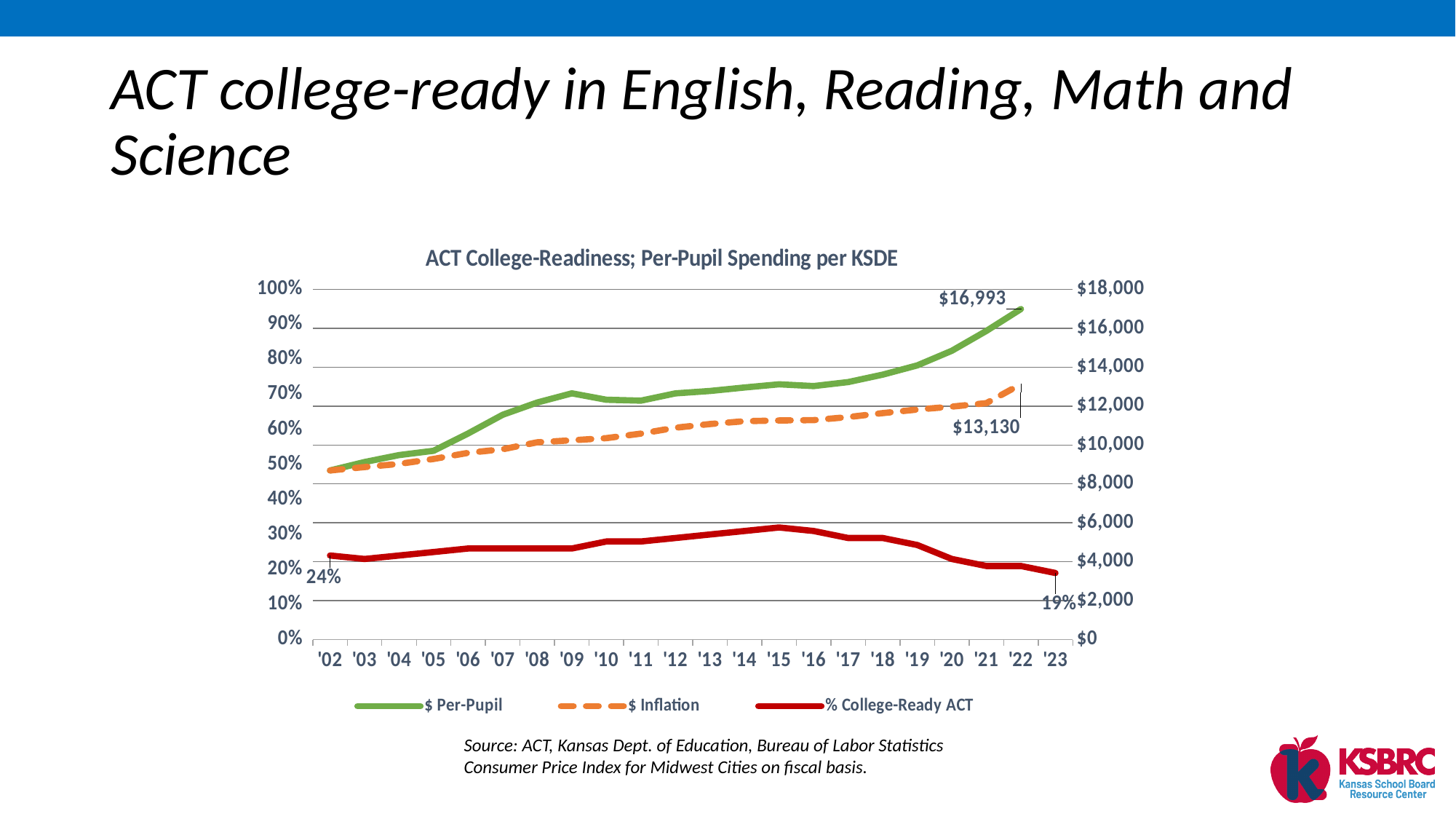
In which year does the % College-Ready ACT series reach its highest point? '15 What is the value of the $ Per-Pupil series in '22? $16,993 Is the % College-Ready ACT value in '15 greater or less than 20%? greater What is the difference between the $ Per-Pupil and $ Inflation values in '22? $3,863 In '22, which is larger: the $ Per-Pupil value or the $ Inflation value? $ Per-Pupil What is the % College-Ready ACT value in '02? 24% What is the % College-Ready ACT value in '23? 19% How many series does the legend list? 3 What is the value of the $ Inflation series in '22? $13,130 Does the $ Per-Pupil series rise or fall from '02 to '22? rise What kind of chart is shown on the slide? line chart Is the $ Per-Pupil value in '02 greater or less than $10,000? less